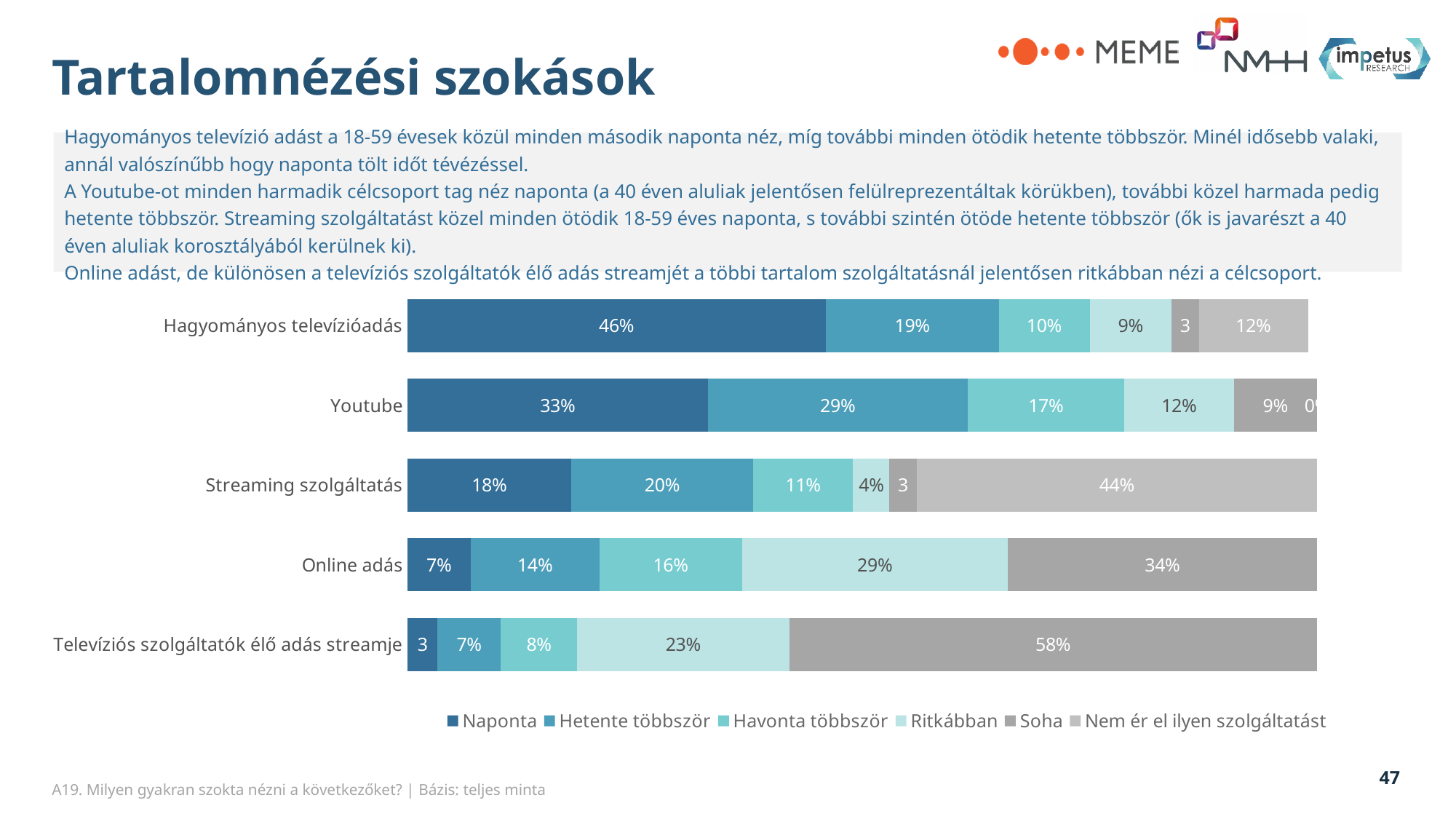
Which category has the lowest Naponta value? Televíziós szolgáltatók élő adás streamje What is the value of Nem ér el ilyen szolgáltatást for Streaming szolgáltatás? 44% What kind of chart is shown on the slide? Stacked bar chart How many categories are shown in the chart? 5 Which has the larger Ritkábban value, Online adás or Streaming szolgáltatás? Online adás What is the value of Soha for Televíziós szolgáltatók élő adás streamje? 58% What is the difference between the Naponta values for Hagyományos televízióadás and Youtube? 13% What is the value of Havonta többször for Online adás? 16% Which category has the highest Naponta value? Hagyományos televízióadás How many series does the legend list? 6 What is the value of Hetente többször for Youtube? 29% What is the value of Naponta for Hagyományos televízióadás? 46%